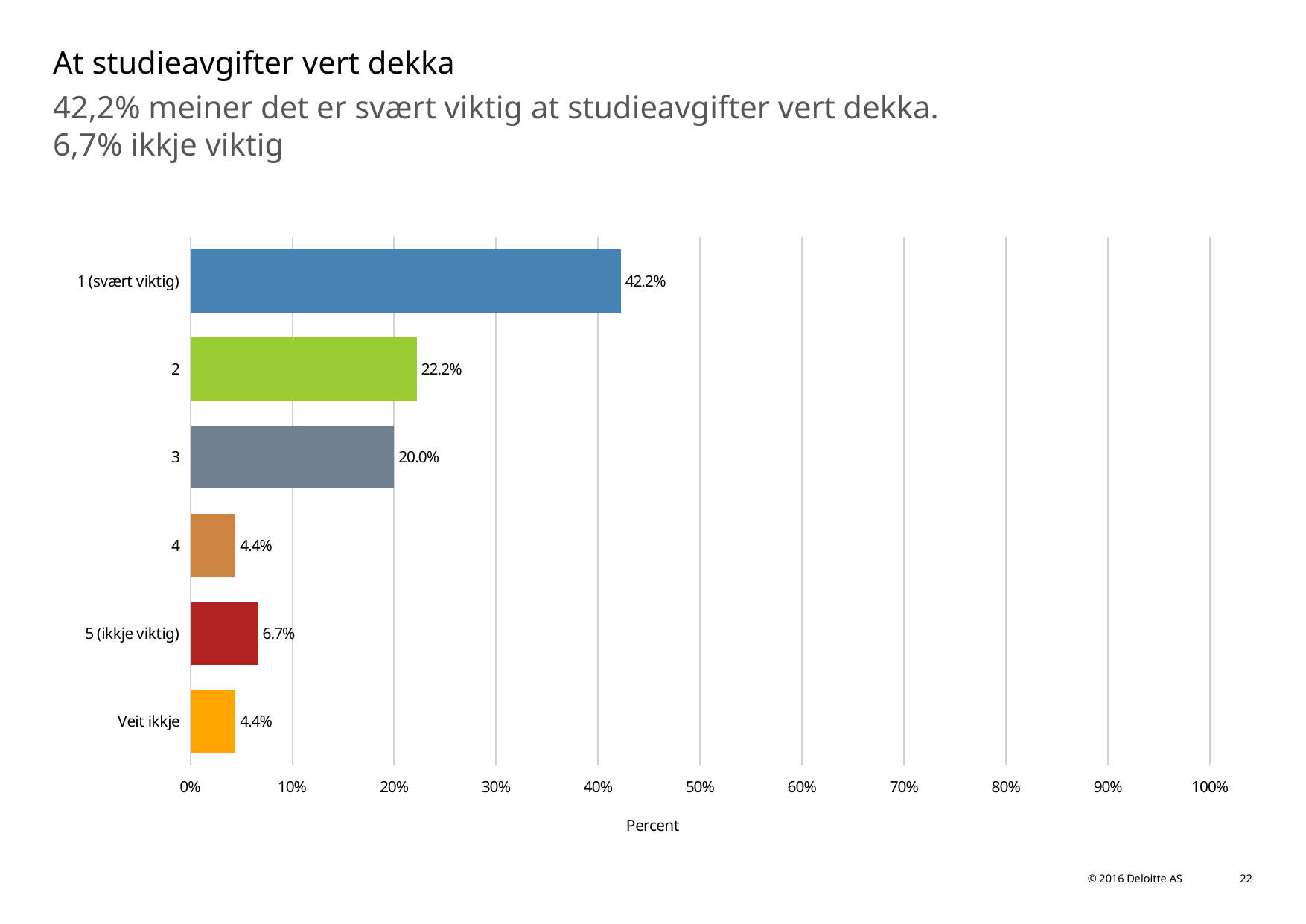
What kind of chart is shown on the slide? bar chart Which is larger, the value for '2' or the value for '3'? 2 What is the label of the horizontal axis? Percent How many categories are shown on the chart? 6 What is the value for the category '1 (svært viktig)'? 42.2% What is the value for the category 'Veit ikkje'? 4.4% What is the value for the category '5 (ikkje viktig)'? 6.7% What is the difference between the values for '1 (svært viktig)' and '2'? 20.0% Is the value for '1 (svært viktig)' greater or less than 40%? greater Which category has the highest value? 1 (svært viktig) What is the difference between the values for '5 (ikkje viktig)' and '4'? 2.3% What is the value for the category '3'? 20.0%